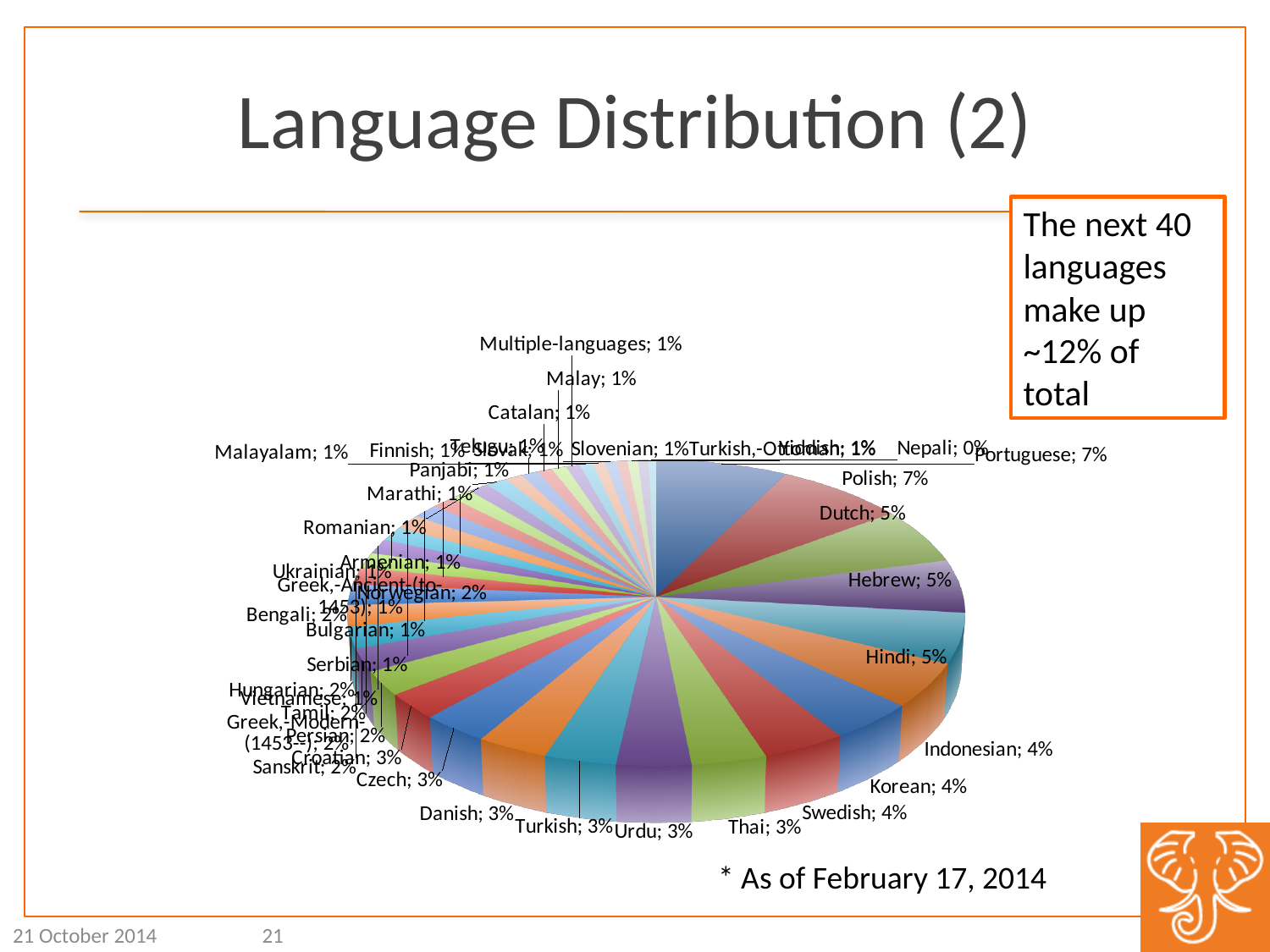
According to the text box on the slide, roughly what share of the total do the next 40 languages make up? ~12% What is the value shown for Sanskrit? 2% What is the difference between the shares of Swedish and Thai? 1% What is the difference between the shares of Polish and Dutch? 2% Which language has the smallest labelled share in the pie? Nepali What kind of chart is shown on the slide? pie chart What is the value shown for Hindi? 5% What is the value shown for Czech? 3% What is the value shown for Indonesian? 4% What share of the pie does Portuguese account for? 7% Which has a larger share, Hebrew or Korean? Hebrew What is the title of the slide containing the chart? Language Distribution (2)